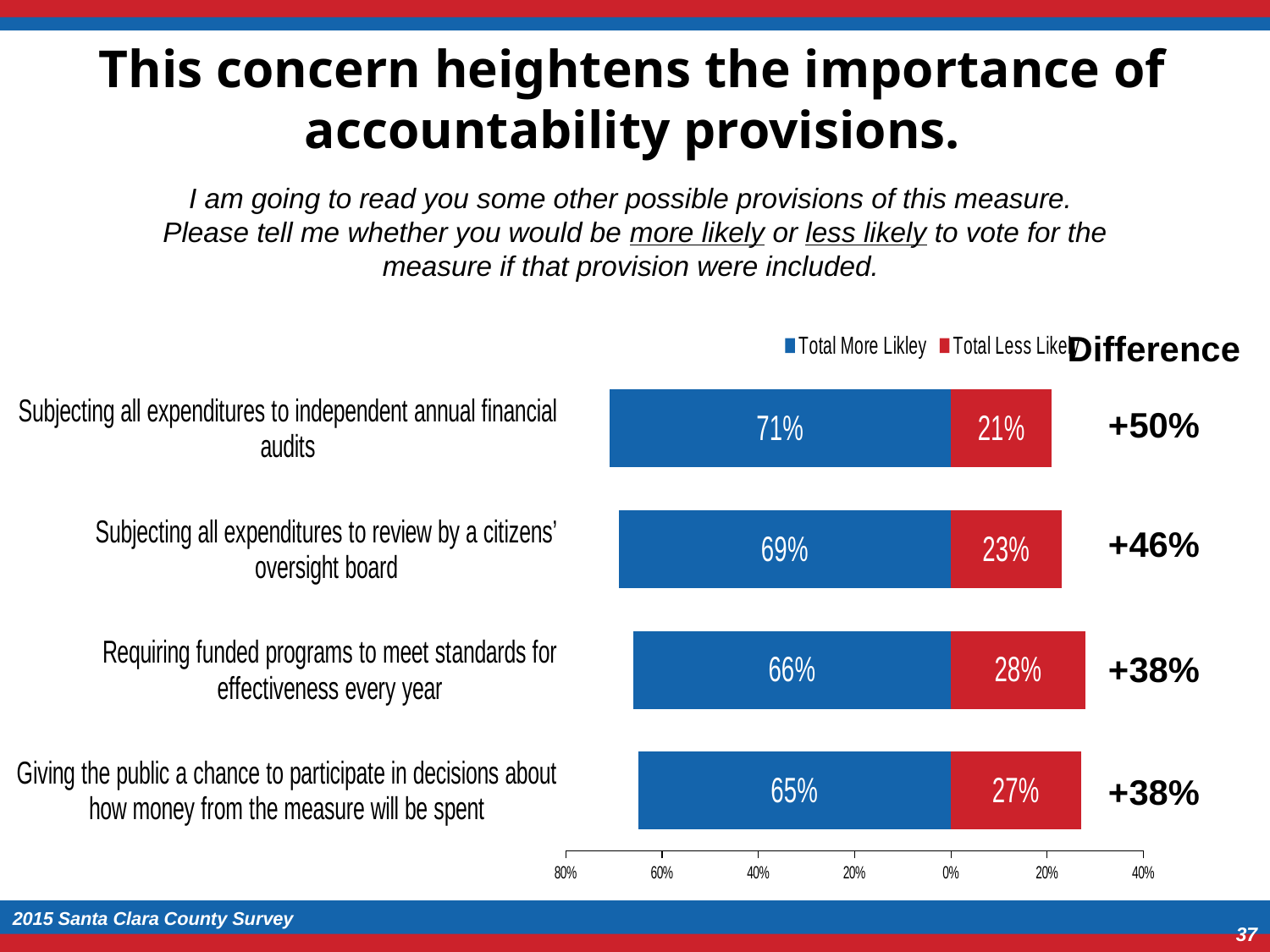
How many series does the legend list? 2 How many provisions are shown in the chart? 4 Which provision has the highest Total More Likely value? Subjecting all expenditures to independent annual financial audits What is the difference between the Total More Likely values for independent annual financial audits and review by a citizens' oversight board? 2% Which is larger: the Total Less Likely value for the citizens' oversight board provision or for the public participation provision? Public participation provision (27%) What percentage said they would be more likely to vote for the measure if it included subjecting all expenditures to independent annual financial audits? 71% Which provision has the lowest Total Less Likely value? Subjecting all expenditures to independent annual financial audits What kind of chart is shown on the slide? Bar chart What is the Total More Likely value for giving the public a chance to participate in decisions about how money from the measure will be spent? 65% Which colour represents Total More Likely in the chart? Blue What is the Total Less Likely value for requiring funded programs to meet standards for effectiveness every year? 28% What is the Difference value shown for subjecting all expenditures to review by a citizens' oversight board? +46%